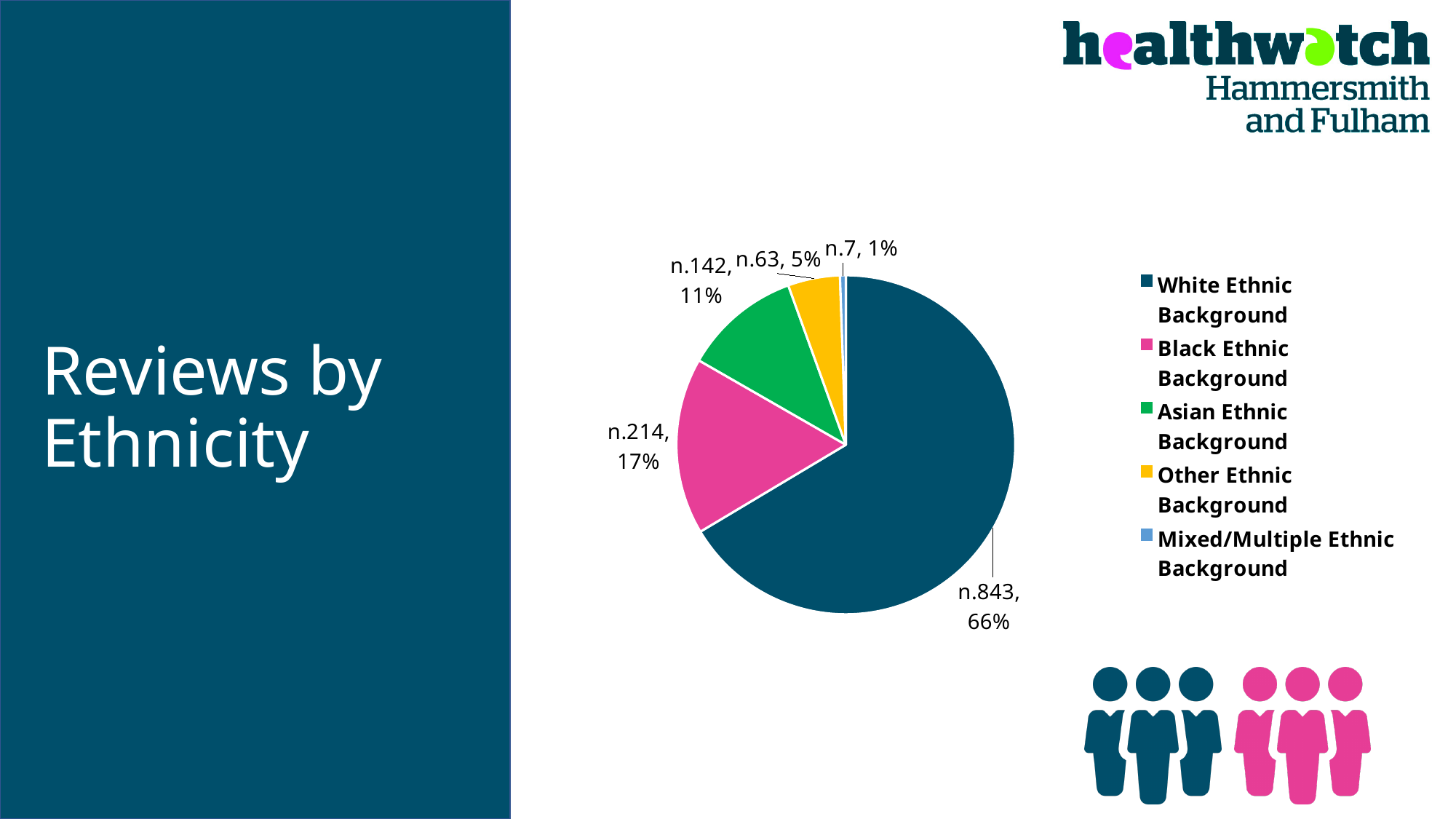
What kind of chart is shown on the slide? Pie chart What percentage of reviews are from Black Ethnic Background? 17% What is the number of reviews for Mixed/Multiple Ethnic Background? 7 What colour represents Black Ethnic Background in the pie chart? Pink What is the number of reviews for Asian Ethnic Background? 142 What percentage of reviews are from Other Ethnic Background? 5% What is the number of reviews for White Ethnic Background? 843 Which ethnic background has the largest share of reviews? White Ethnic Background How many categories does the pie chart show? 5 Which has more reviews, Asian Ethnic Background or Other Ethnic Background? Asian Ethnic Background Which ethnic background has the smallest share of reviews? Mixed/Multiple Ethnic Background What is the difference in the number of reviews between Black Ethnic Background and Asian Ethnic Background? 72